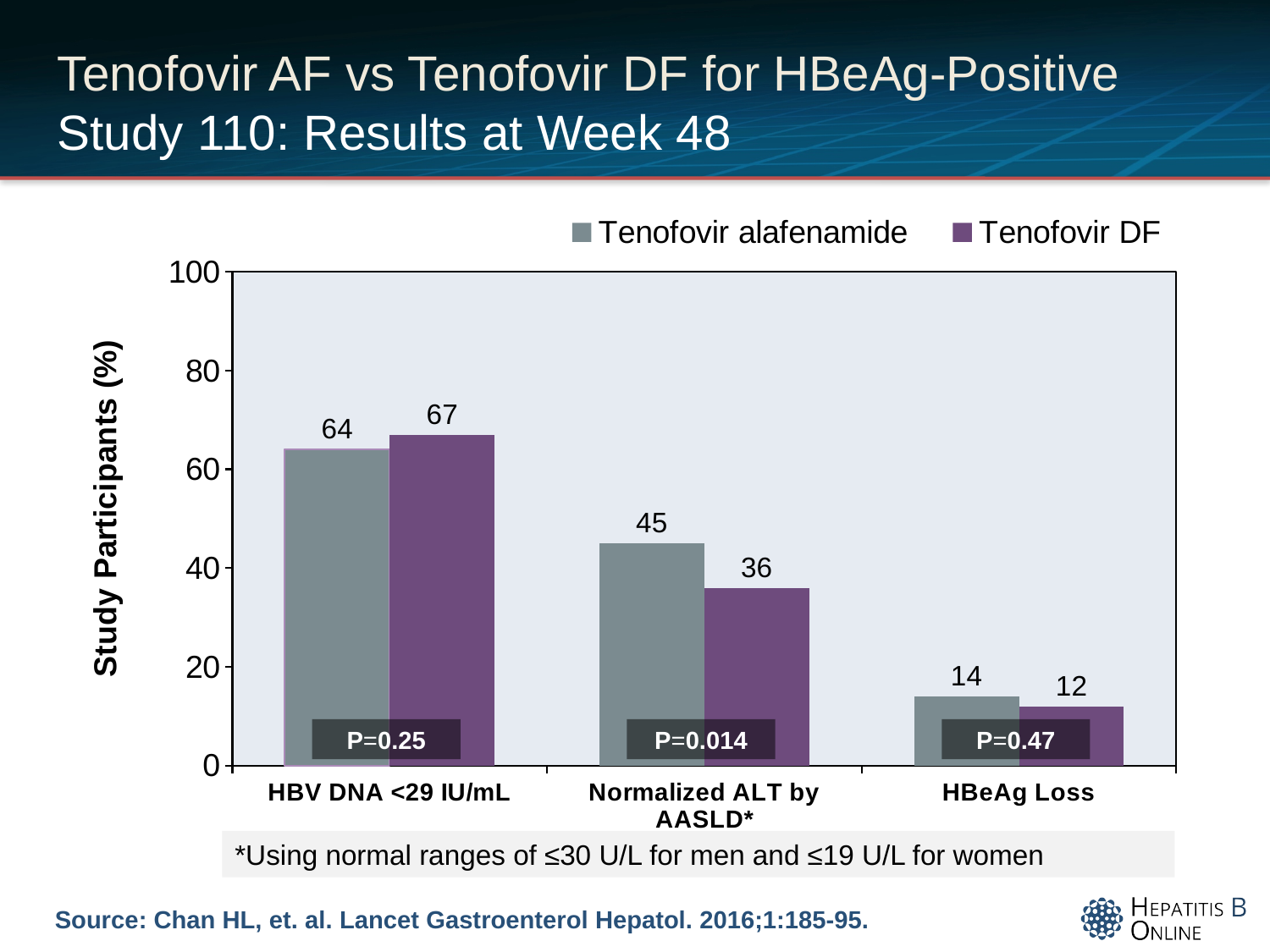
What is the value for Tenofovir alafenamide in the HBV DNA <29 IU/mL category? 64 How many categories are shown on the x axis? 3 What is the value for Tenofovir DF in the Normalized ALT by AASLD* category? 36 Which category has the highest value for Tenofovir DF? HBV DNA <29 IU/mL Which category has the lowest value for Tenofovir alafenamide? HBeAg Loss What is the difference between the Tenofovir alafenamide and Tenofovir DF values in the Normalized ALT by AASLD* category? 9 How many series does the legend list? 2 In the HBV DNA <29 IU/mL category, which series has the larger value? Tenofovir DF Is the value for Tenofovir alafenamide in the HBeAg Loss category greater or less than 20? less What kind of chart is shown on the slide? bar chart What is the value for Tenofovir DF in the HBeAg Loss category? 12 What is the y-axis label of the chart? Study Participants (%)